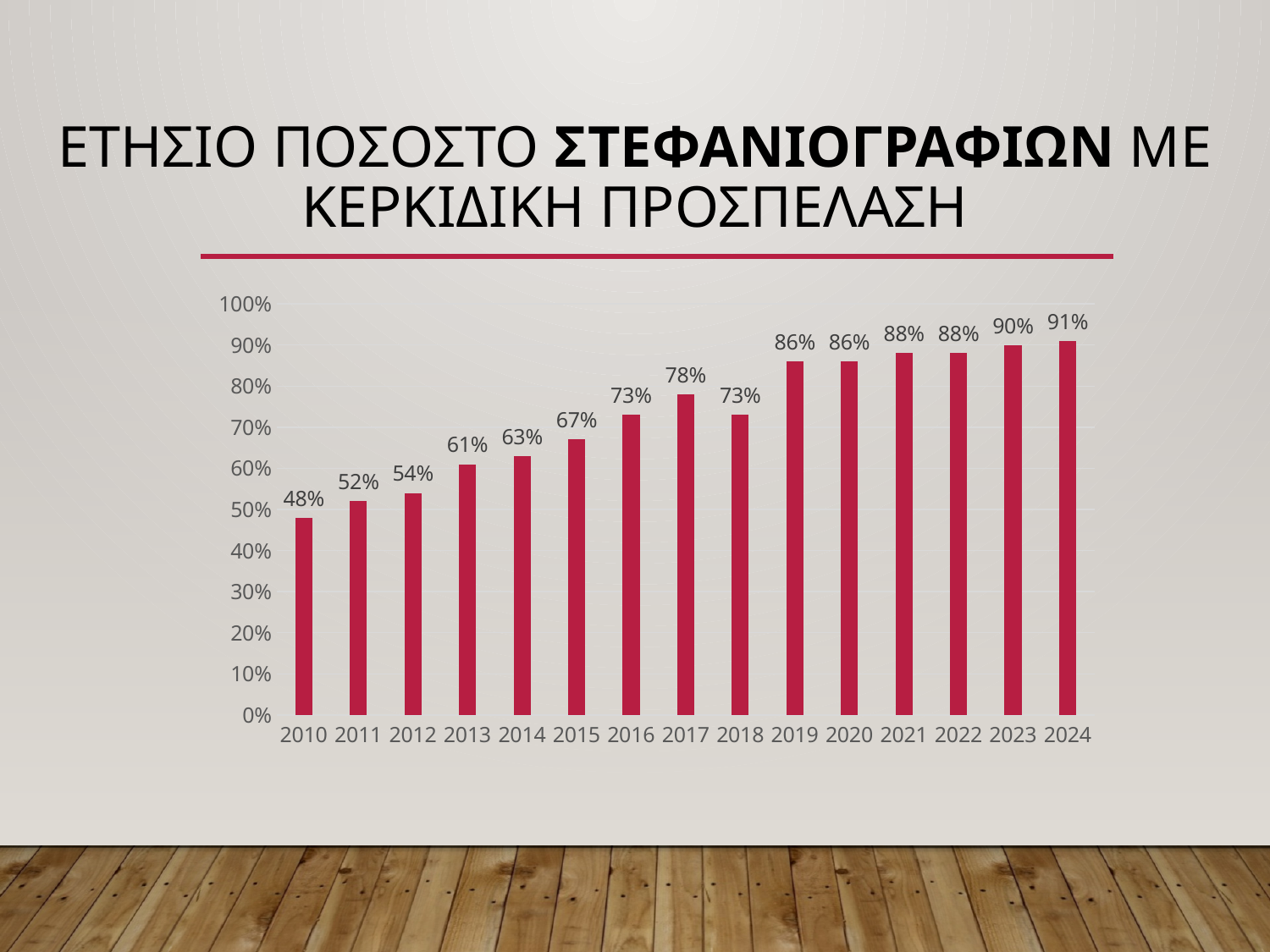
What is the value for 2010? 48% What kind of chart is this? bar chart How many years are shown on the x axis? 15 Which year has the highest value? 2024 What is the difference between the values for 2024 and 2010? 43% Which is larger, the value for 2017 or the value for 2018? 2017 What is the value for 2017? 78% Do the values generally rise or fall from 2010 to 2024? rise Is the value for 2015 greater or less than 60%? greater What is the value for 2024? 91% Which year has the lowest value? 2010 What colour are the bars? red